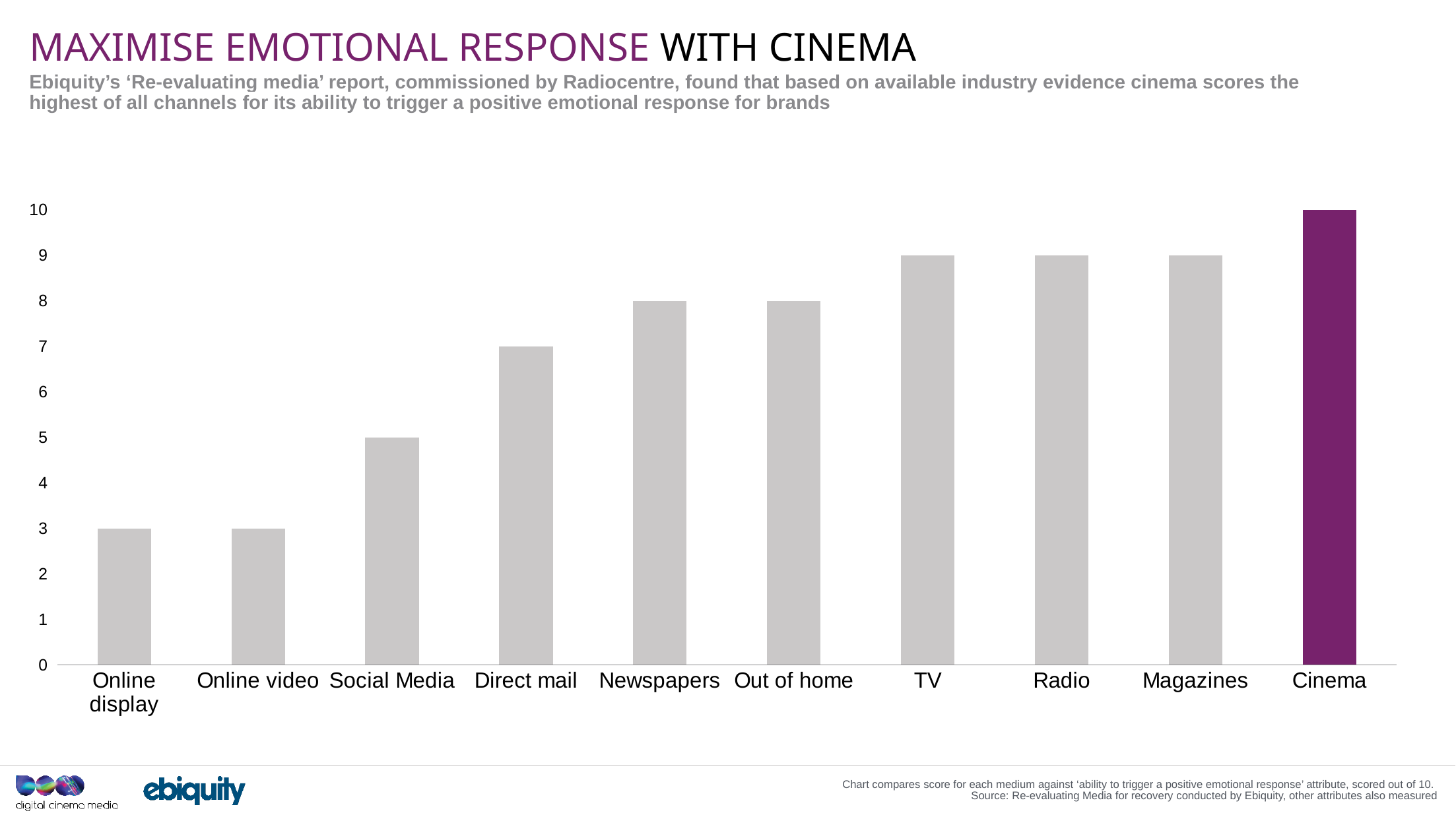
What score does TV reach on the chart? 9 What is the difference between the scores for Cinema and Online display? 7 What score does Direct mail reach on the chart? 7 Is the score for Online video greater or less than 5? less Which is larger, the score for Newspapers or the score for Social Media? Newspapers Which bar is coloured purple rather than grey? Cinema How many media categories are plotted on the chart? 10 What score does Cinema reach on the chart? 10 Do the scores generally rise or fall moving from left to right across the chart? Rise Which medium has the highest score on the chart? Cinema What kind of chart is shown on the slide? Bar chart What score does Social Media reach on the chart? 5